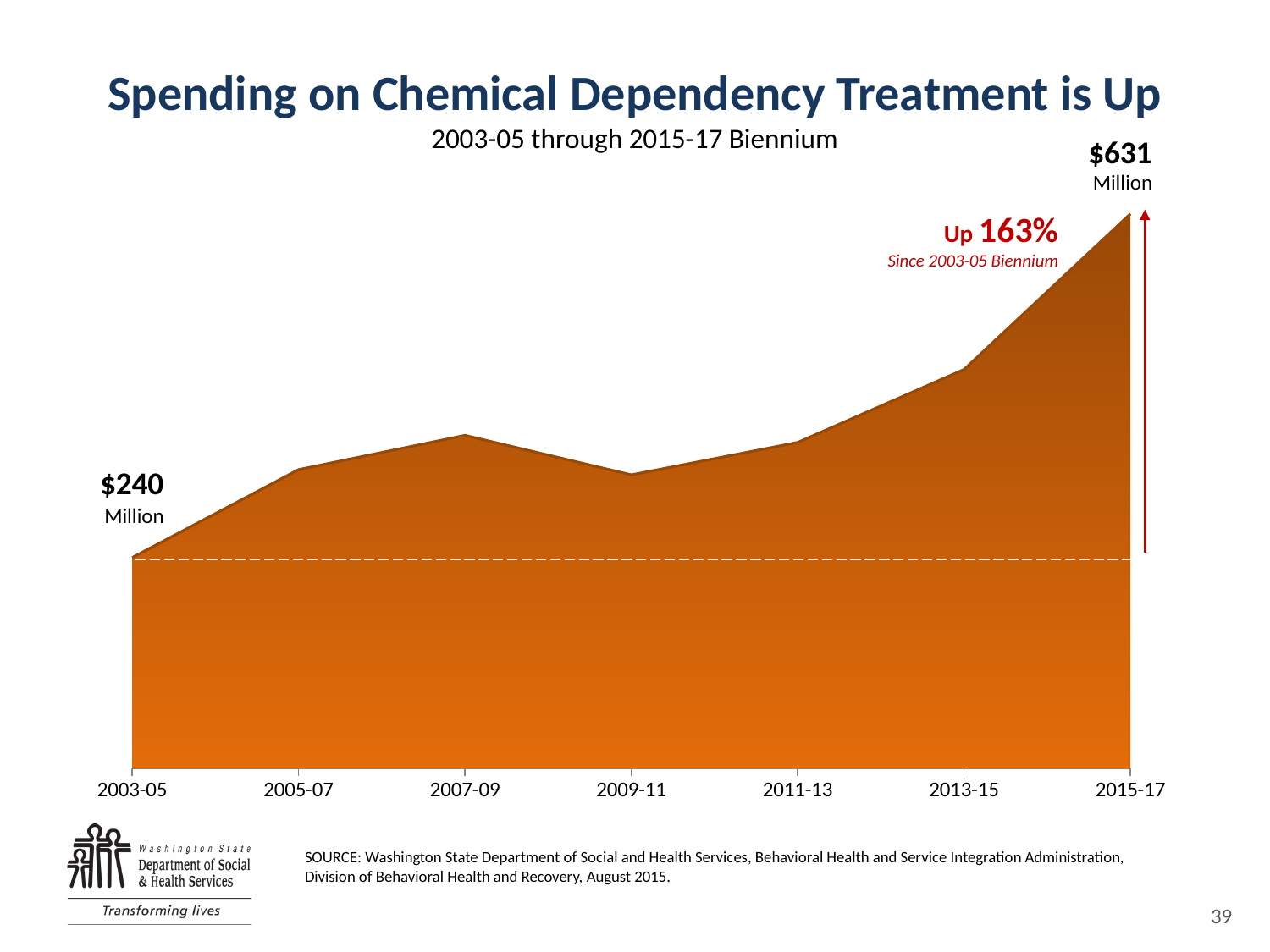
What is the title of the chart? Spending on Chemical Dependency Treatment is Up How many biennia are plotted on the chart? 7 What kind of chart is shown on the slide? Area chart Which biennium has higher spending, 2011-13 or 2013-15? 2013-15 Does spending generally rise or fall from 2003-05 to 2015-17? Rise What is the spending value shown for the 2003-05 biennium? $240 Million What is the spending value shown for the 2015-17 biennium? $631 Million By what percentage has spending increased since the 2003-05 biennium, according to the slide? 163% Which biennium has higher spending, 2007-09 or 2009-11? 2007-09 Which biennium has the highest spending on chemical dependency treatment? 2015-17 What is the difference in spending between the 2015-17 and 2003-05 biennia? $391 Million Which biennium has the lowest spending on chemical dependency treatment? 2003-05